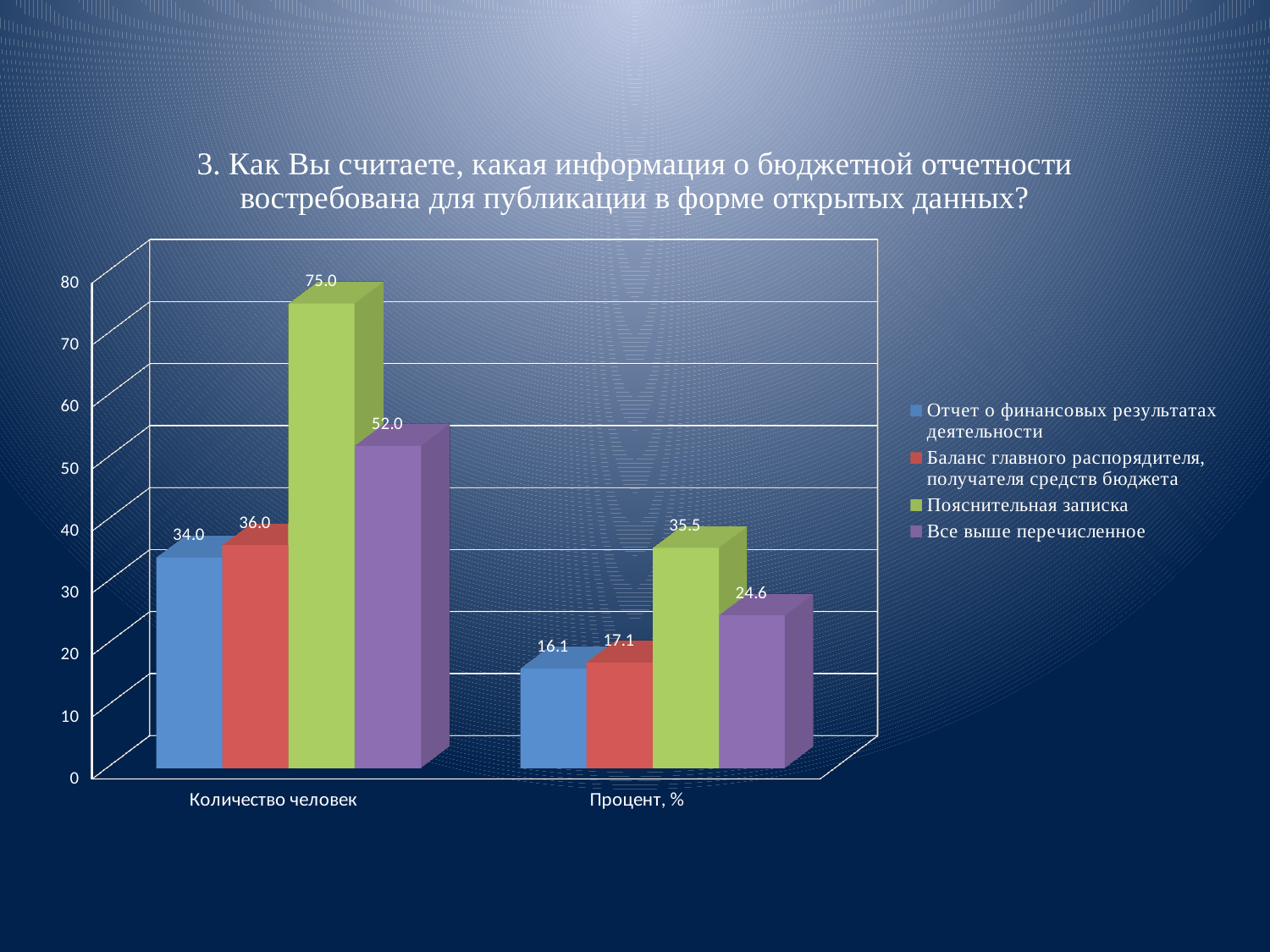
How many series does the legend list? 4 What is the title of the chart? 3. Как Вы считаете, какая информация о бюджетной отчетности востребована для публикации в форме открытых данных? Is the value for "Пояснительная записка" in the "Количество человек" category greater or less than 70? greater What is the value for "Пояснительная записка" in the "Количество человек" category? 75.0 Which series has the lowest value in the "Количество человек" category? Отчет о финансовых результатах деятельности Which is larger in the "Процент, %" category: "Баланс главного распорядителя, получателя средств бюджета" or "Все выше перечисленное"? Все выше перечисленное What is the value for "Отчет о финансовых результатах деятельности" in the "Количество человек" category? 34.0 What is the difference between the "Пояснительная записка" and "Все выше перечисленное" values in the "Количество человек" category? 23.0 Which series has the highest value in the "Процент, %" category? Пояснительная записка How many categories are shown on the x axis? 2 What kind of chart is shown on the slide? Bar chart What is the value for "Все выше перечисленное" in the "Процент, %" category? 24.6